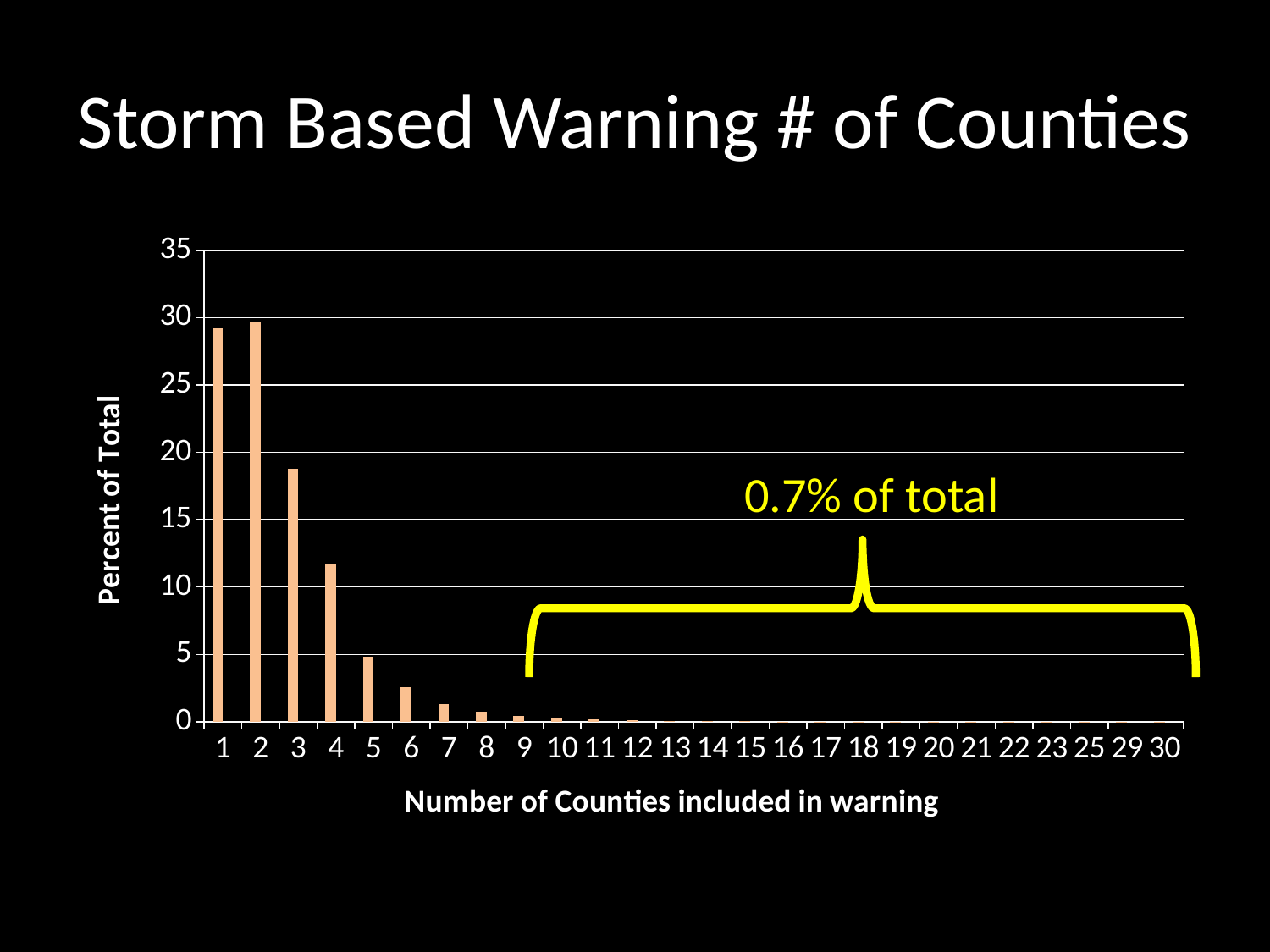
What kind of chart is shown on the slide? bar chart What is the label of the y axis? Percent of Total Which has a larger value, 3 counties or 4 counties? 3 counties Is the value for 4 counties greater or less than 10? greater How many categories are shown on the x axis of the chart? 26 Is the value for 3 counties greater or less than 15? greater Which has a larger value, 1 county or 3 counties? 1 county Is the value for 1 county greater or less than 25? greater What is the title of the chart? Storm Based Warning # of Counties Do the values generally rise or fall as the number of counties increases along the x axis? fall